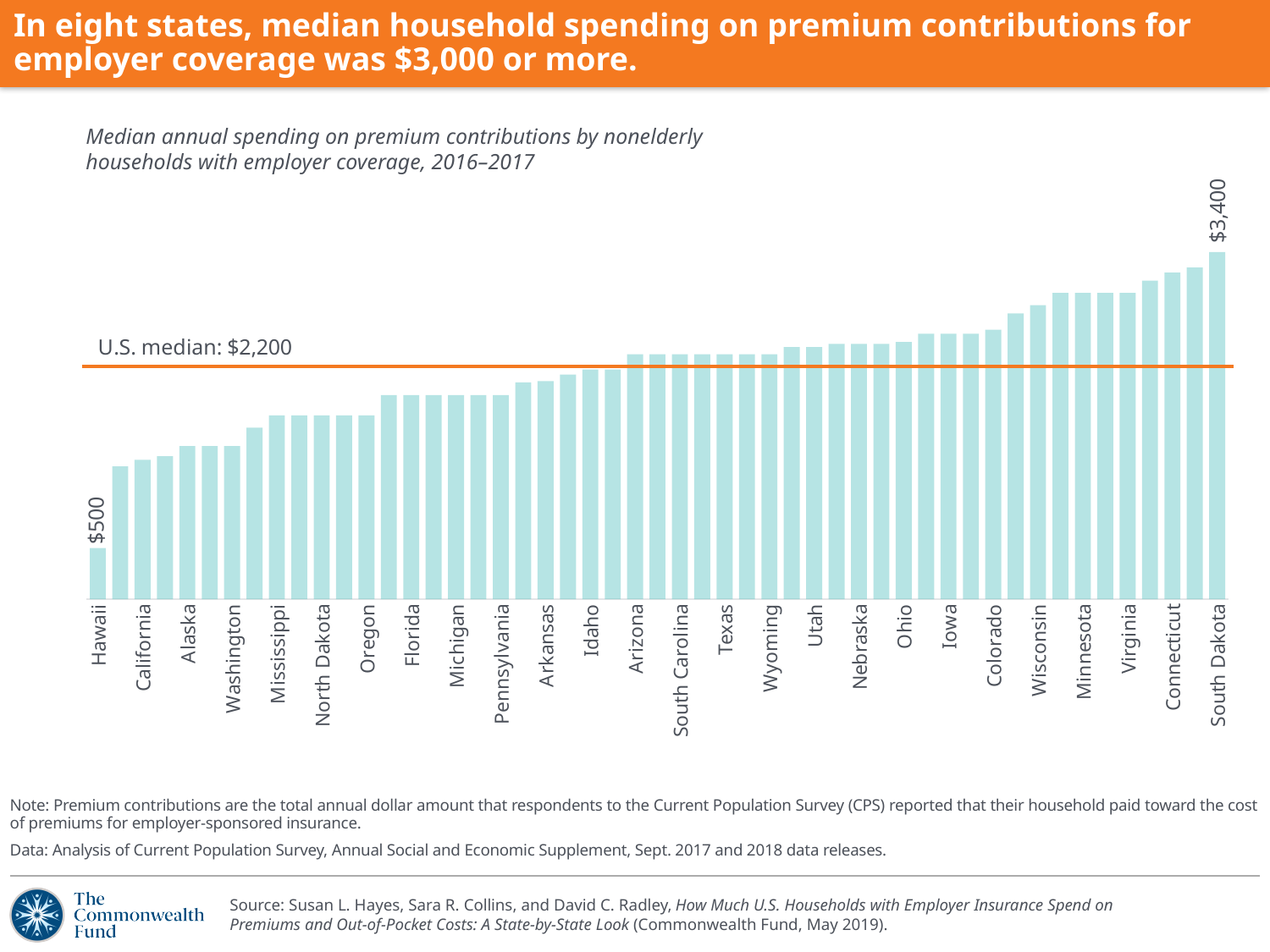
What is the median annual spending on premium contributions for South Dakota? $3,400 Do the values rise or fall moving from left to right across the states? rise Which state has the lowest median annual spending on premium contributions? Hawaii Is the value for Florida greater or less than the U.S. median of $2,200? less What U.S. median value is marked by the horizontal line on the chart? $2,200 Which state has higher median spending on premium contributions, Connecticut or California? Connecticut What is the median annual spending on premium contributions for Hawaii? $500 What kind of chart is shown on the slide? bar chart Which state has higher median spending on premium contributions, Wisconsin or Oregon? Wisconsin Which state has the highest median annual spending on premium contributions? South Dakota What is the difference between South Dakota's and Hawaii's median annual spending on premium contributions? $2,900 Is the value for Colorado greater or less than the U.S. median of $2,200? greater